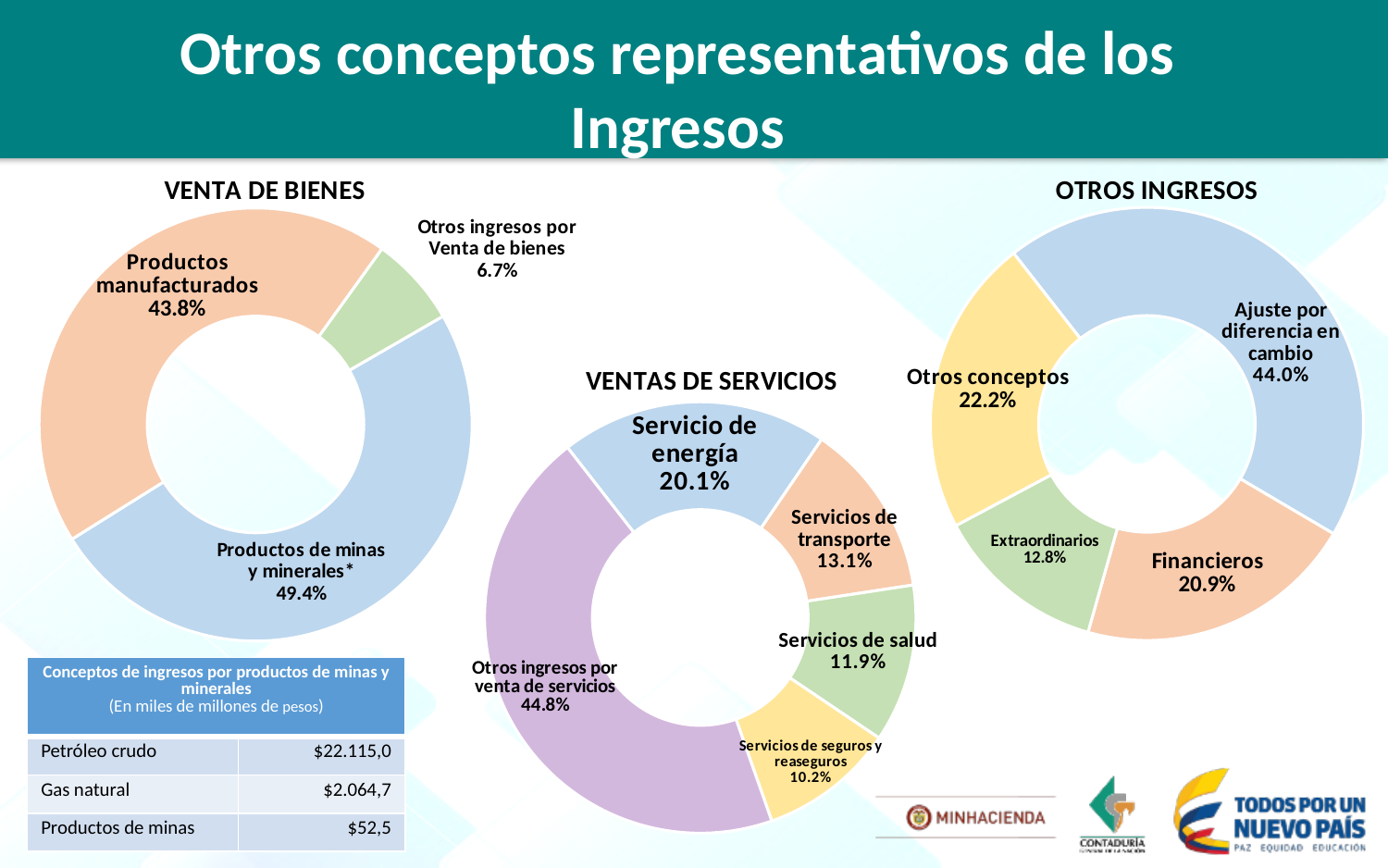
In the VENTA DE BIENES chart, what share is shown for Productos manufacturados? 43.8% In the VENTA DE BIENES chart, which category has the largest share? Productos de minas y minerales* In the VENTAS DE SERVICIOS chart, what is the difference in percentage points between Servicios de transporte and Servicios de salud? 1.2 In the VENTAS DE SERVICIOS chart, which category has the largest share? Otros ingresos por venta de servicios In the VENTAS DE SERVICIOS chart, what share is shown for Servicio de energía? 20.1% In the VENTAS DE SERVICIOS chart, which category has the smallest share? Servicios de seguros y reaseguros In the VENTA DE BIENES chart, which category has the smallest share? Otros ingresos por Venta de bienes What kind of chart is the OTROS INGRESOS chart? Doughnut chart In the OTROS INGRESOS chart, what share is shown for Financieros? 20.9% In the VENTA DE BIENES chart, how many categories are shown? 3 In the VENTAS DE SERVICIOS chart, how many categories are shown? 5 In the OTROS INGRESOS chart, which is larger, Otros conceptos or Extraordinarios? Otros conceptos